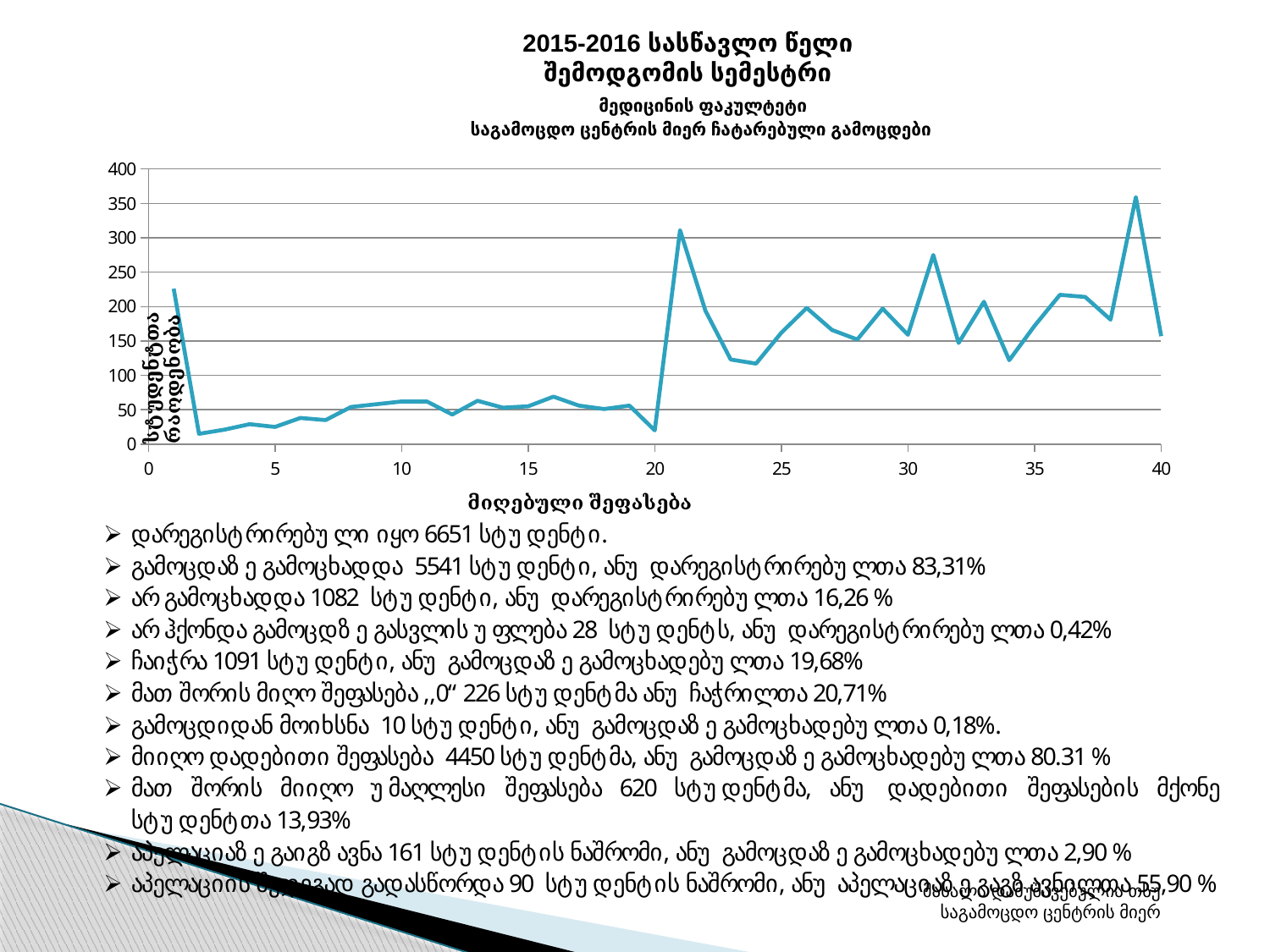
At which x-axis value (score) does the line reach its highest point? 39 Is the value at score 1 greater or less than 200? greater What is the label of the x axis of the chart? მიღებული შეფასება What kind of chart is shown on the slide? line chart Which is larger, the value at score 1 or the value at score 20? score 1 Is the value at score 21 greater or less than 250? greater Is the value at score 39 greater or less than 300? greater Does the line rise or fall between score 20 and score 21? rise Which is larger, the value at score 21 or the value at score 31? score 21 What is the highest tick value shown on the y axis of the chart? 400